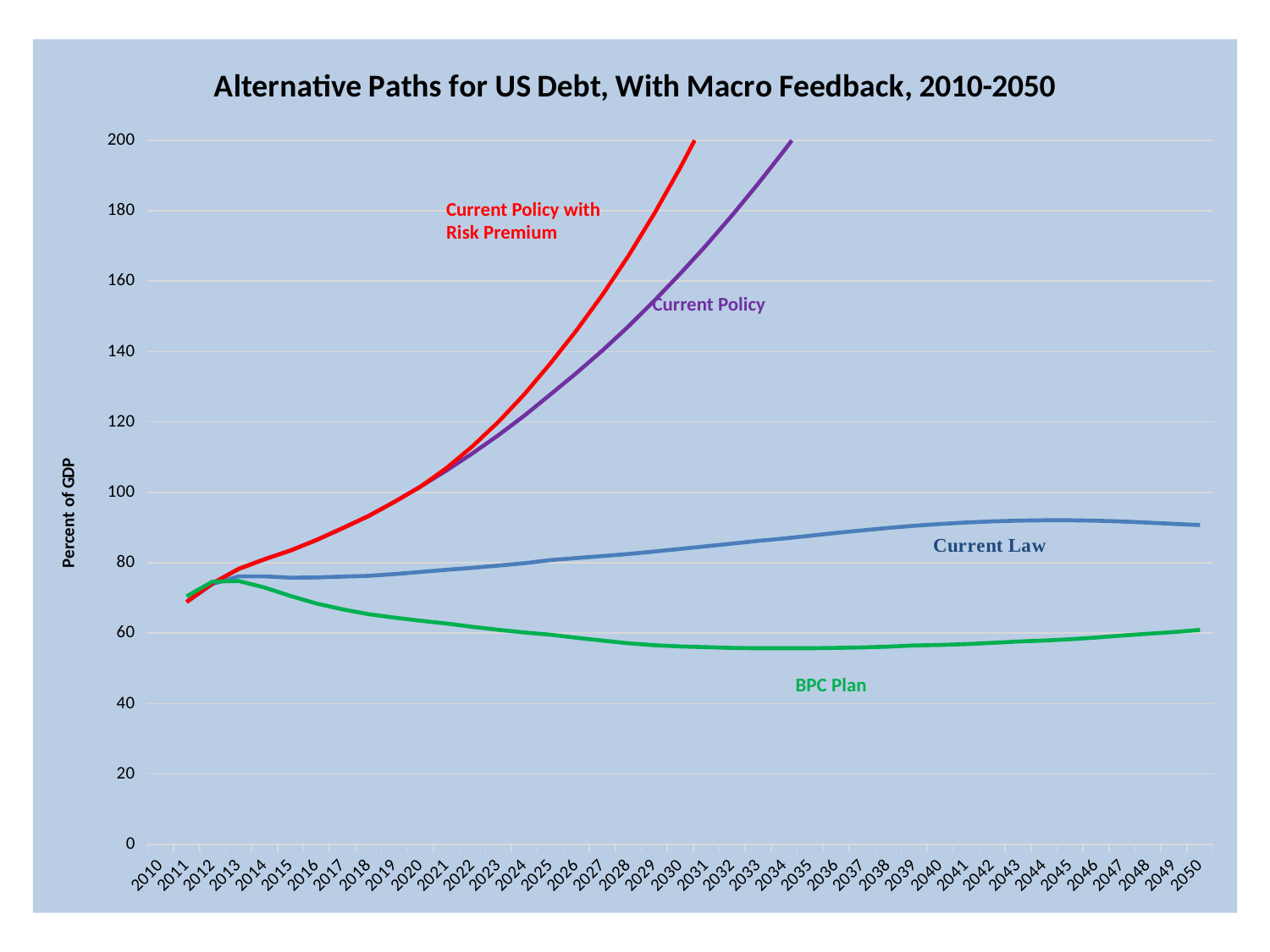
In 2028, which is larger: the value for Current Policy with Risk Premium or the value for Current Policy? Current Policy with Risk Premium Is the value for BPC Plan in 2050 greater or less than 80? less Is the value for Current Policy in 2030 greater or less than 140? greater In 2050, which is larger: the value for Current Law or the value for BPC Plan? Current Law Is the value for Current Law in 2045 greater or less than 80? greater Which series has the highest value in 2030? Current Policy with Risk Premium Does the Current Policy line rise or fall from 2015 to 2030? rise What is the title of the chart? Alternative Paths for US Debt, With Macro Feedback, 2010-2050 Which series has the lowest value in 2050? BPC Plan What is the label on the vertical axis of the chart? Percent of GDP How many series (lines) are plotted on the chart? 4 What kind of chart is shown on the slide? line chart